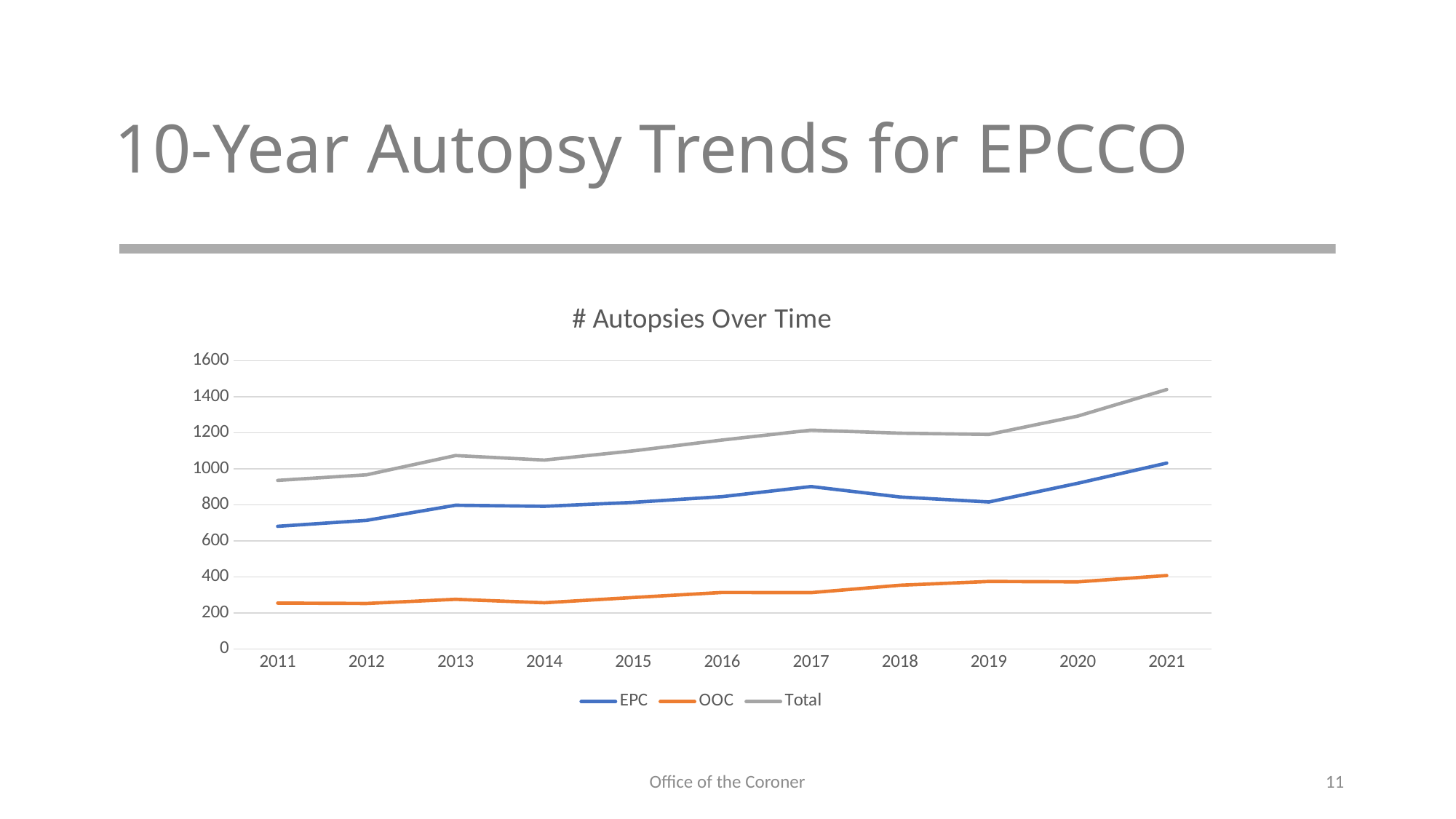
What kind of chart is shown on the slide? line chart In which year is the EPC series lowest? 2011 In which year is the Total series highest? 2021 Is the Total value for 2021 greater or less than 1400? greater Is the EPC value for 2021 greater or less than 1000? greater Does the Total series rise or fall from 2019 to 2021? rise How many years are plotted along the x axis? 11 How many series does the legend list? 3 Is the OOC value for 2019 greater or less than 400? less Which is larger, the EPC value for 2017 or the EPC value for 2019? 2017 What is the title of the chart? # Autopsies Over Time